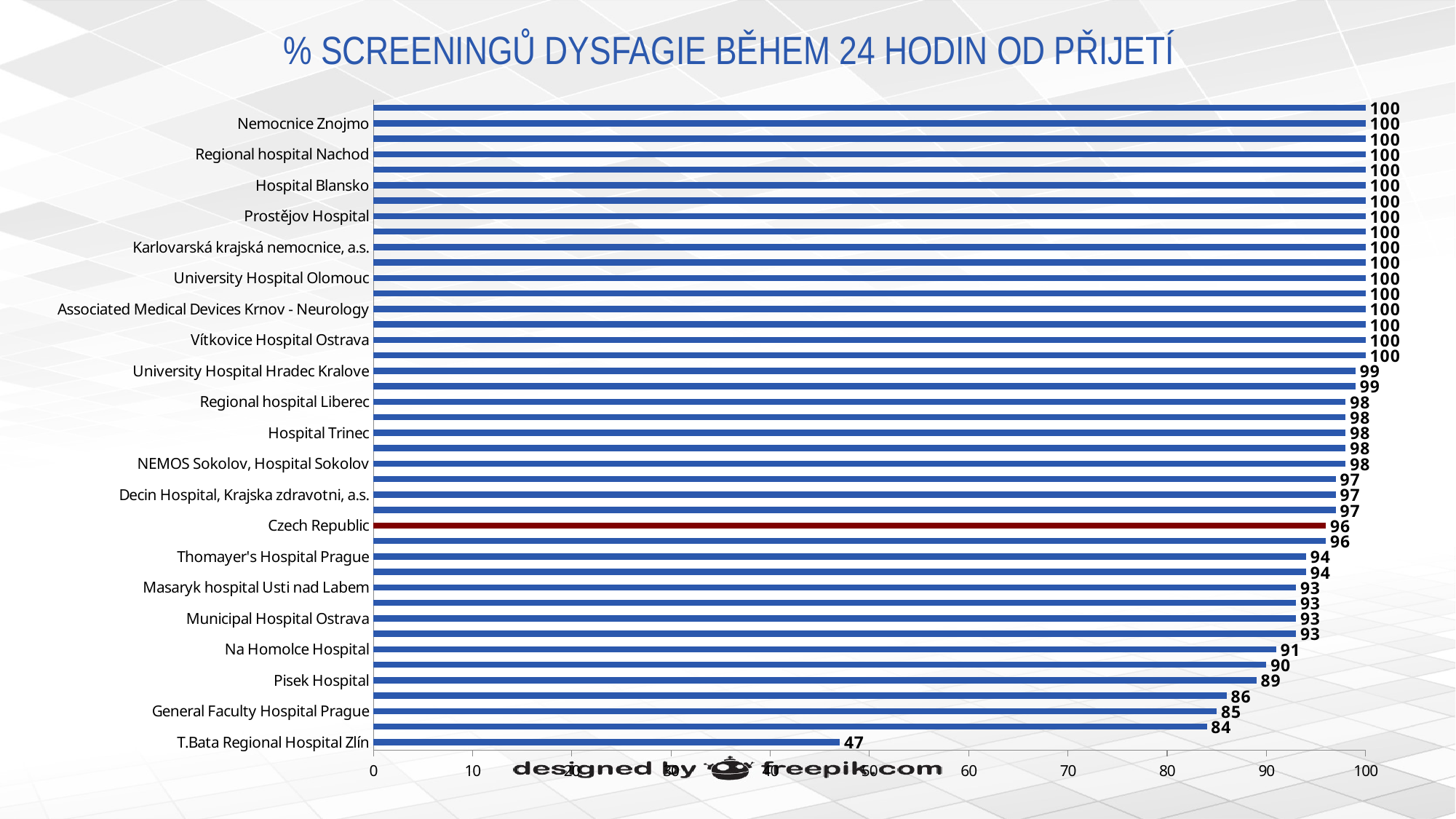
What colour is the bar for Czech Republic? red Which labelled hospital has the lowest value? T.Bata Regional Hospital Zlín What is the difference between the value for Czech Republic and the value for T.Bata Regional Hospital Zlín? 49 Which is larger, the value for Pisek Hospital or the value for General Faculty Hospital Prague? Pisek Hospital What is the value for Na Homolce Hospital? 91 What is the value for University Hospital Hradec Kralove? 99 Do the bar values increase or decrease going from the top of the chart to the bottom? decrease What is the value for Czech Republic? 96 What is the value for Pisek Hospital? 89 Is the value for T.Bata Regional Hospital Zlín greater or less than 50? less What kind of chart is shown on the slide? bar chart What is the value for T.Bata Regional Hospital Zlín? 47